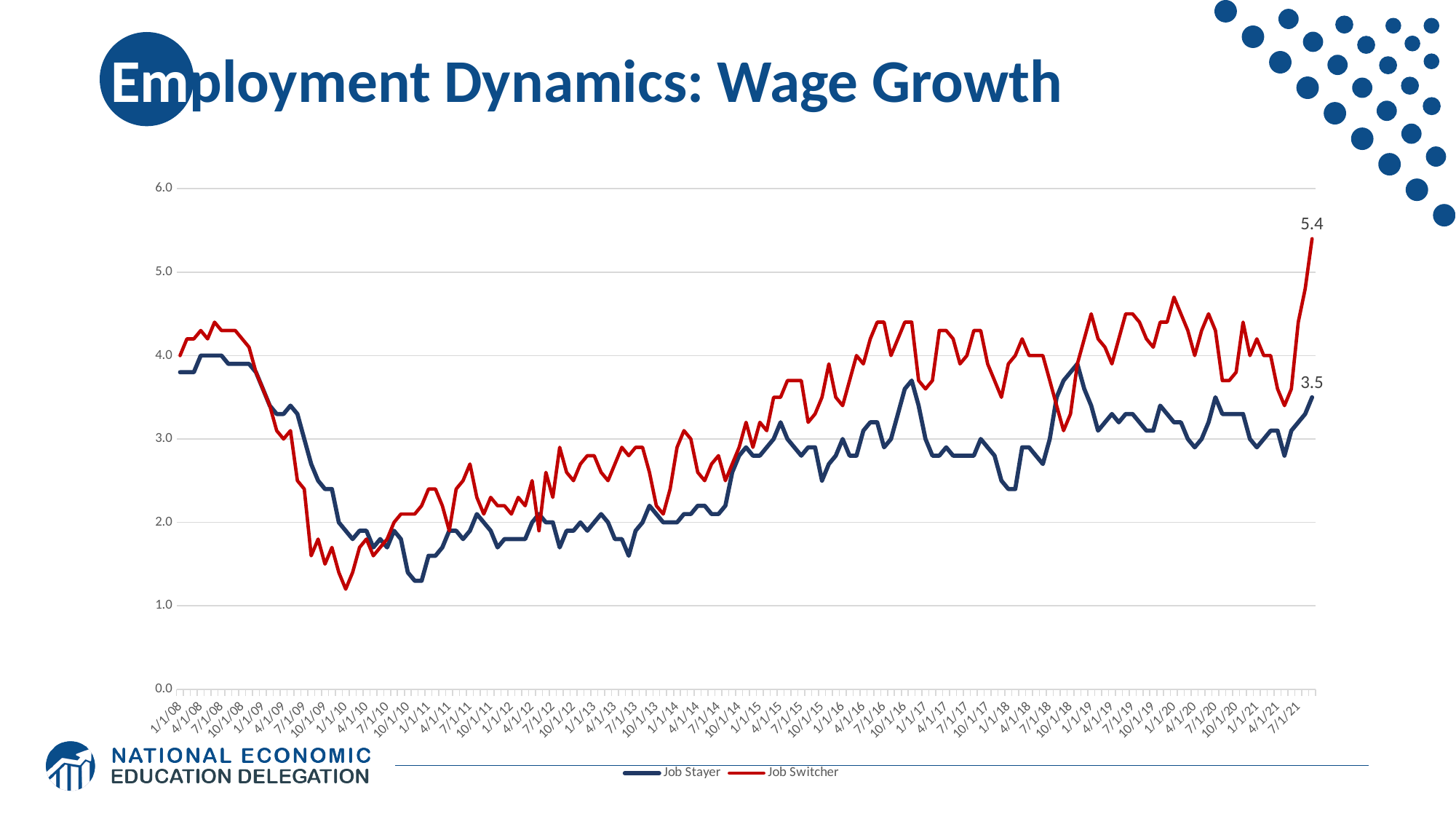
Does the Job Switcher series rise or fall between 1/1/09 and 1/1/10? Fall What is the labelled final value of the Job Switcher series? 5.4 Which series is drawn in red? Job Switcher How many series does the legend list? 2 What is the labelled final value of the Job Stayer series? 3.5 Which series reaches the highest value shown on the chart? Job Switcher Is the value for Job Stayer at 1/1/08 greater or less than 3.0? greater At the last point on the chart, which series is higher, Job Stayer or Job Switcher? Job Switcher What is the difference between the labelled final values of Job Switcher and Job Stayer? 1.9 Is the value for Job Switcher at 1/1/10 greater or less than 2.0? less What kind of chart is shown on the slide? Line chart Is the value for Job Stayer at 1/1/11 greater or less than 2.0? less